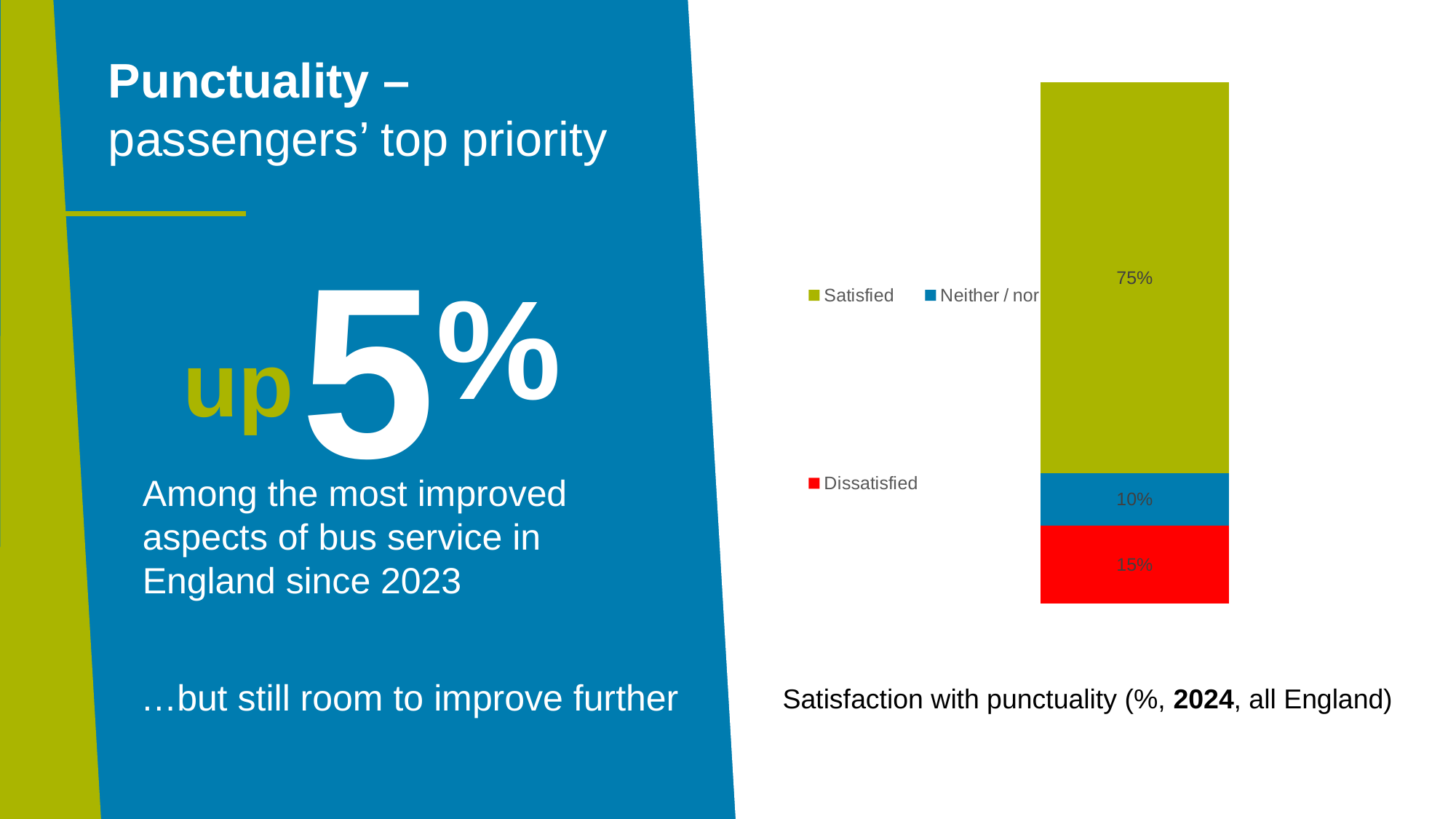
What is the difference between the Dissatisfied and Neither / nor percentages? 5% Which is larger, the Dissatisfied share or the Neither / nor share? Dissatisfied Which segment of the stacked bar has the smallest value? Neither / nor Which segment of the stacked bar has the largest value? Satisfied What is the difference between the Satisfied and Dissatisfied percentages? 60% What is the total of the three segments in the stacked bar? 100% What percentage of passengers are dissatisfied with punctuality in the chart? 15% How many series does the chart legend list? 3 What value is shown for the 'Neither / nor' segment of the bar? 10% What colour is the Satisfied segment of the bar? Green What percentage of passengers are satisfied with punctuality in the chart? 75% What type of chart is shown on the slide? Stacked bar chart